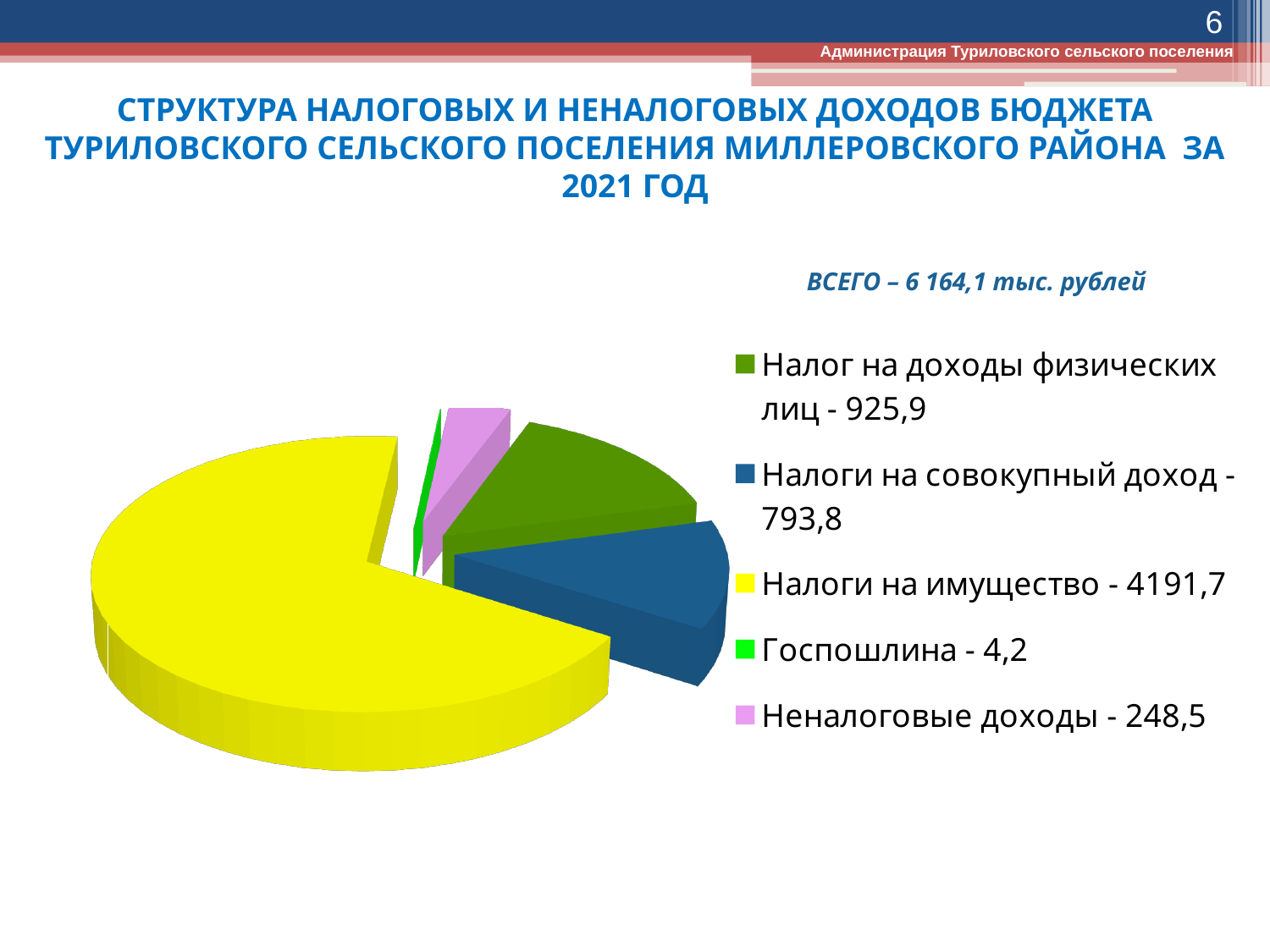
What is the value for Налоги на имущество? 4191,7 What kind of chart is shown on the slide? pie chart What is the value for Госпошлина? 4,2 Which is larger: Налог на доходы физических лиц or Налоги на совокупный доход? Налог на доходы физических лиц Which category has the largest slice of the pie? Налоги на имущество What is the difference between Налог на доходы физических лиц and Налоги на совокупный доход? 132,1 What total amount (ВСЕГО) is stated on the slide? 6 164,1 тыс. рублей How many categories does the pie chart have? 5 Which category has the smallest slice of the pie? Госпошлина What is the value for Неналоговые доходы? 248,5 What is the value for Налог на доходы физических лиц? 925,9 What colour is the slice for Налоги на совокупный доход? blue